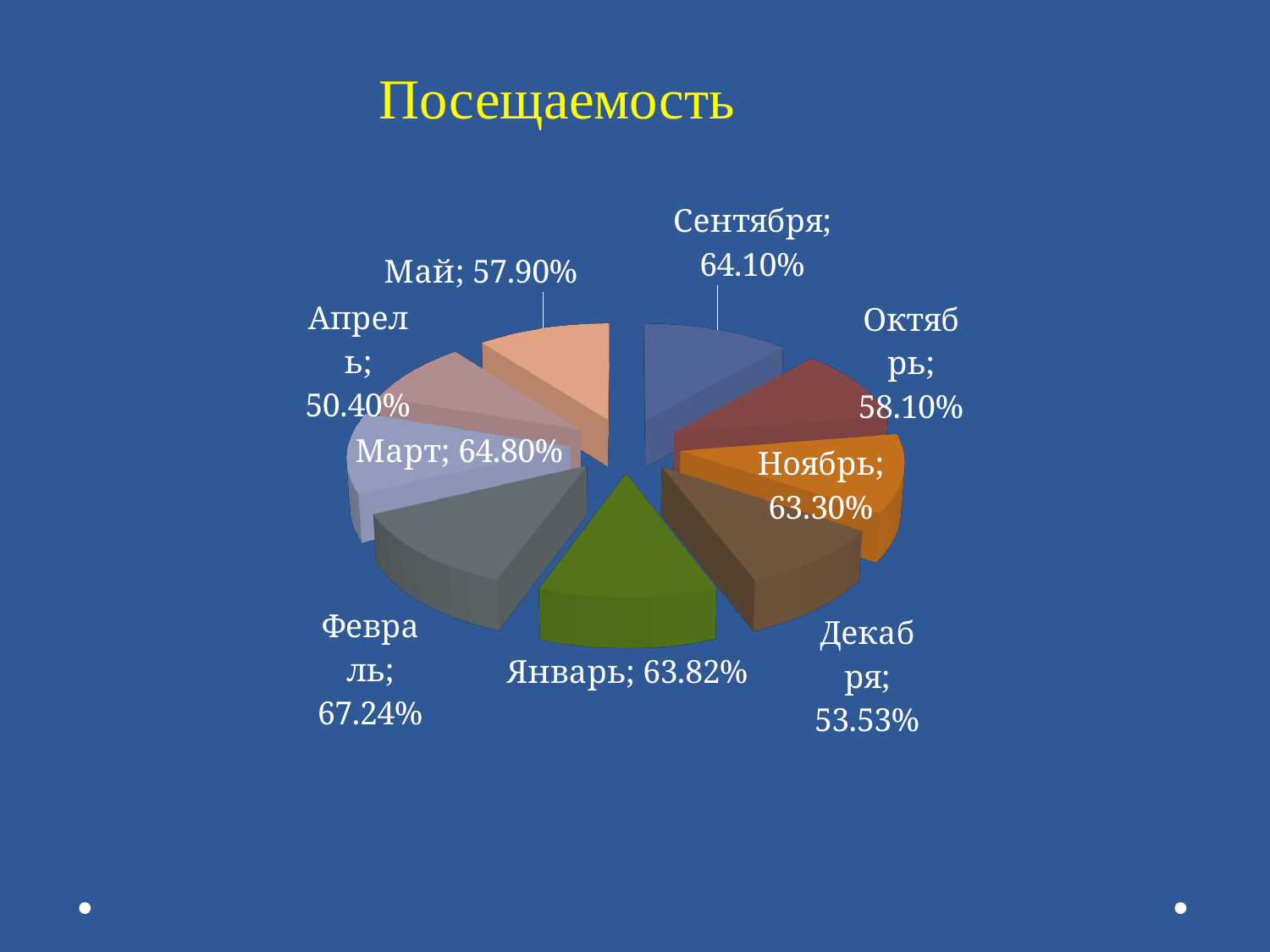
What value is shown for Январь on the pie chart? 63.82% Which month has the highest value on the pie chart? Февраль How many slices does the pie chart have? 9 What type of chart is shown on the slide? Pie chart What value is shown for Декабря on the pie chart? 53.53% What value is shown for Май on the pie chart? 57.90% What is the title of the slide? Посещаемость Which has a larger value, Ноябрь or Декабря? Ноябрь Which month has the lowest value on the pie chart? Апрель What is the difference between the values for Февраль and Апрель? 16.84% What is the difference between the values for Март and Октябрь? 6.70% What value is shown for Сентября on the pie chart? 64.10%